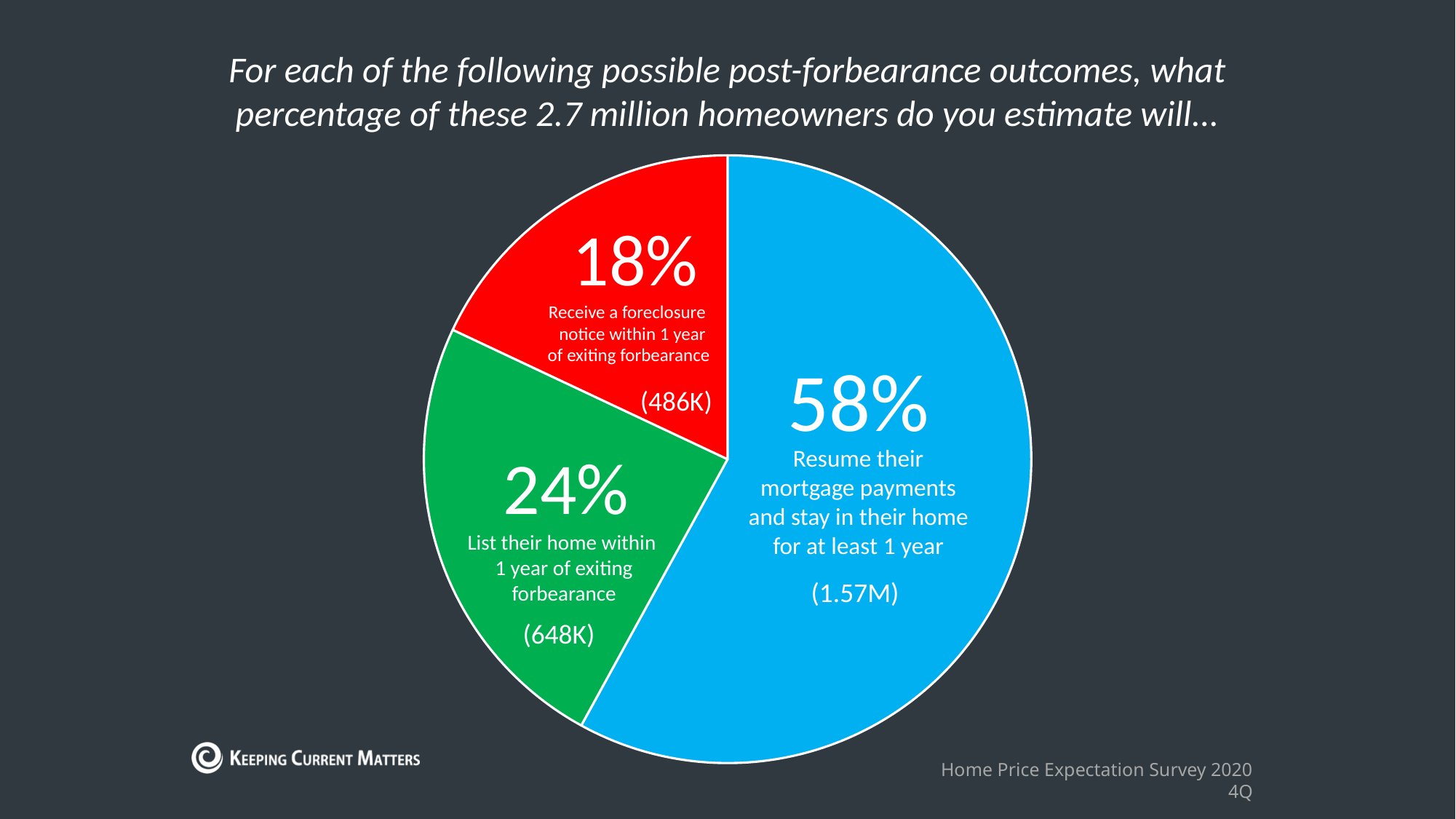
What is the difference in percentage points between the slice for resuming mortgage payments and the slice for listing their home? 34 How many homeowners does the slice for resuming mortgage payments represent? 1.57M What percentage of homeowners are estimated to receive a foreclosure notice within 1 year of exiting forbearance? 18% What colour is the slice for receiving a foreclosure notice within 1 year of exiting forbearance? red Which outcome has the largest share of the pie? Resume their mortgage payments and stay in their home for at least 1 year How many homeowners does the slice for listing their home within 1 year represent? 648K What percentage of homeowners are estimated to list their home within 1 year of exiting forbearance? 24% What kind of chart is shown on the slide? pie chart How many slices does the pie chart have? 3 Which is larger: the share for listing their home within 1 year or the share for receiving a foreclosure notice? List their home within 1 year of exiting forbearance Which outcome has the smallest share of the pie? Receive a foreclosure notice within 1 year of exiting forbearance What percentage of homeowners are estimated to resume their mortgage payments and stay in their home for at least 1 year? 58%